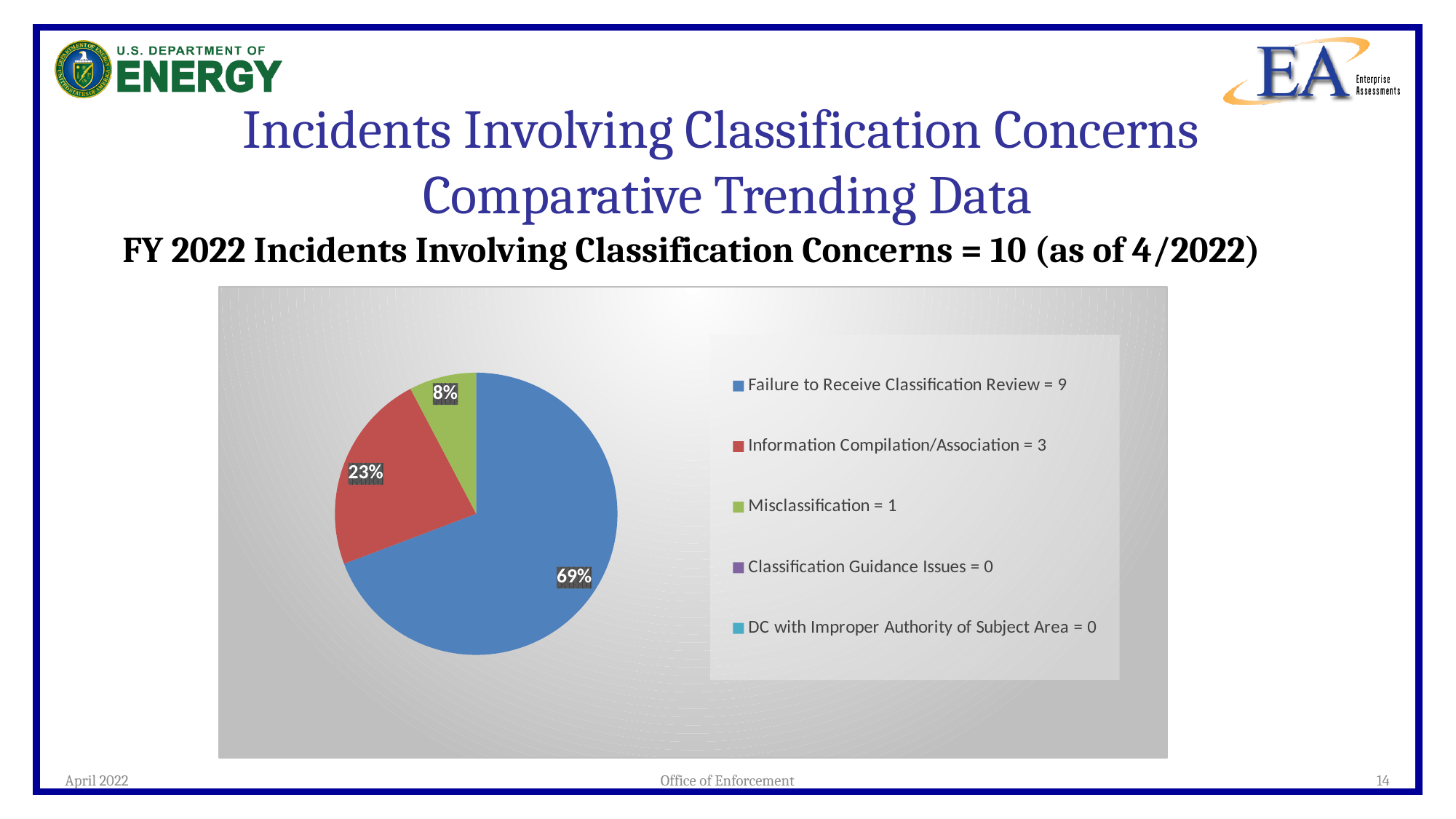
According to the legend, how many incidents are attributed to Information Compilation/Association? 3 According to the legend, how many incidents are attributed to Failure to Receive Classification Review? 9 How many categories does the legend list? 5 What percentage share of the pie does Information Compilation/Association have? 23% Which colour represents Information Compilation/Association in the pie chart? Red Which category has the largest slice of the pie? Failure to Receive Classification Review What kind of chart is shown on the slide? Pie chart Which category with a visible slice has the smallest share of the pie? Misclassification What percentage share of the pie does Misclassification have? 8% What is the difference in percentage points between the Failure to Receive Classification Review slice and the Information Compilation/Association slice? 46 percentage points According to the legend, how many incidents are attributed to Misclassification? 1 What percentage share of the pie does Failure to Receive Classification Review have? 69%